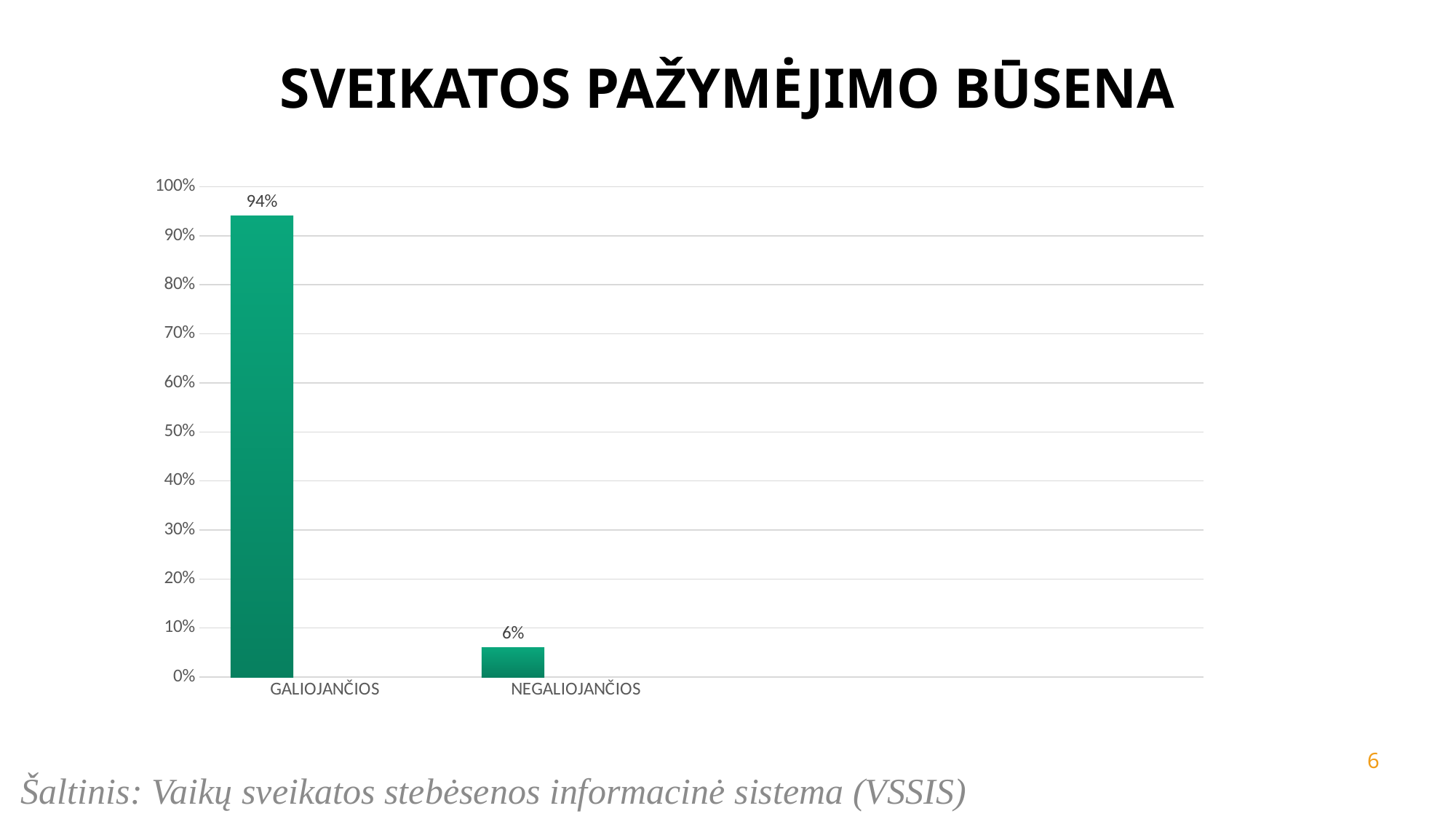
Is the value for GALIOJANČIOS greater or less than 90%? greater How many categories are shown on the x axis? 2 Is the value for NEGALIOJANČIOS greater or less than 10%? less Which category has the lowest value? NEGALIOJANČIOS What is the value for GALIOJANČIOS? 94% What is the value for NEGALIOJANČIOS? 6% Which is larger, the value for GALIOJANČIOS or the value for NEGALIOJANČIOS? GALIOJANČIOS What is the highest value shown on the y axis? 100% What is the difference between the values for GALIOJANČIOS and NEGALIOJANČIOS? 88% What kind of chart is shown on the slide? bar chart What is the title of the chart? SVEIKATOS PAŽYMĖJIMO BŪSENA Which category has the highest value? GALIOJANČIOS